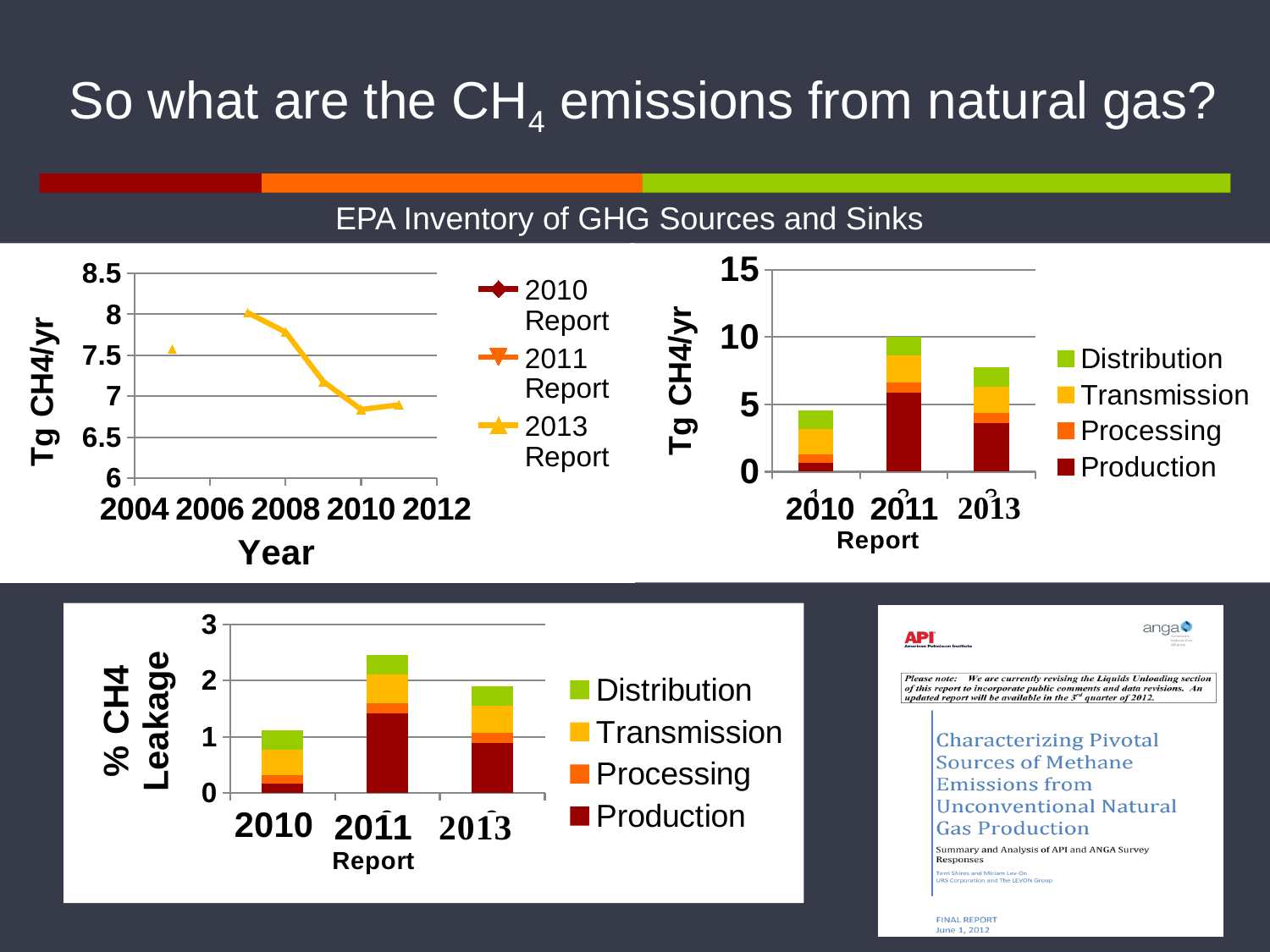
In the top-left line chart, is the 2013 Report value for 2007 greater or less than 7.5? greater In the bottom-left % CH4 Leakage chart, is the total for the 2011 report greater or less than 2? greater In the top-right stacked bar chart (Tg CH4/yr), which report has the highest total? 2011 How many series does the legend of the top-left line chart list? 3 In the top-left line chart, is the 2013 Report value for 2010 greater or less than 7? less In the top-left line chart, does the 2013 Report series rise or fall between 2007 and 2010? fall In the bottom-left % CH4 Leakage chart, which report has the lowest total? 2010 What kind of chart is the top-right chart with the Report axis and Tg CH4/yr y-axis? stacked bar chart How many series does the legend of the top-right stacked bar chart list? 4 How many report categories are shown on the x-axis of the bottom-left % CH4 Leakage chart? 3 What kind of chart is the top-left chart with the Year axis? line chart